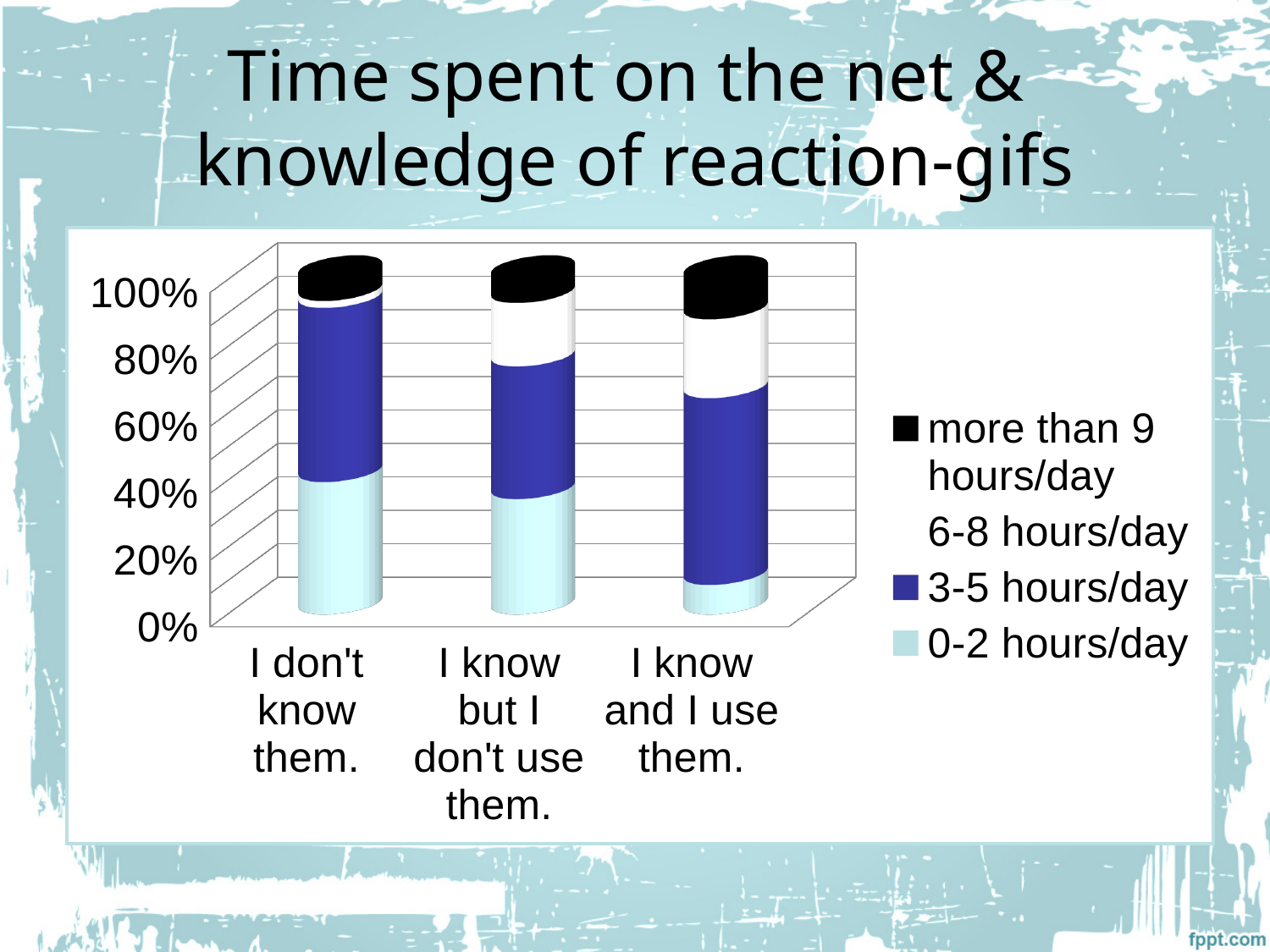
How many series does the legend list? 4 Is the 0-2 hours/day share for "I know and I use them." greater or less than 20%? less Which legend entry is shown in black? more than 9 hours/day Which category has the largest 6-8 hours/day share? I know and I use them. Does the 0-2 hours/day share rise or fall across the categories from left to right? fall How many categories are shown on the x axis of the chart? 3 Which category has a larger 0-2 hours/day share: "I don't know them." or "I know and I use them."? I don't know them. What is the title of the slide? Time spent on the net & knowledge of reaction-gifs Is the 3-5 hours/day share for "I know and I use them." greater or less than 40%? greater Is the 0-2 hours/day share for "I don't know them." greater or less than 20%? greater What kind of chart is shown on the slide? Stacked bar chart Which category has the smallest 0-2 hours/day share? I know and I use them.